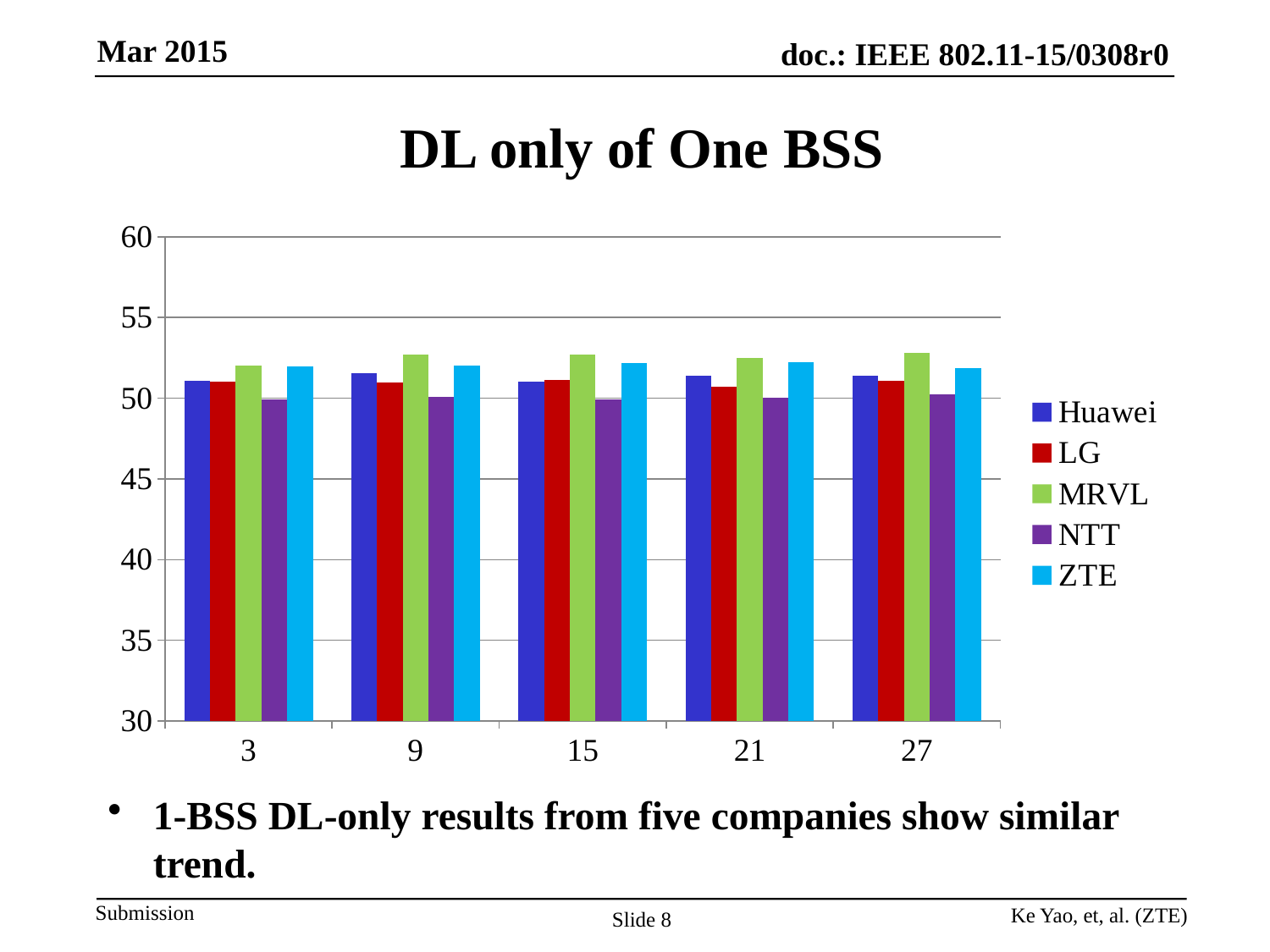
How many categories are shown on the x axis? 5 Which series has the lowest value at category 15? NTT Is the value for MRVL at category 15 greater or less than 55? less Which series has the lowest value at category 21? NTT Which series does the legend list last? ZTE Which series has the highest value at category 27? MRVL At category 3, which is larger: the value for Huawei or the value for NTT? Huawei What kind of chart is shown on the slide? bar chart How many series does the legend list? 5 At category 9, which is larger: the value for MRVL or the value for NTT? MRVL What is the title of the chart? DL only of One BSS Is the value for NTT at category 27 greater or less than 45? greater